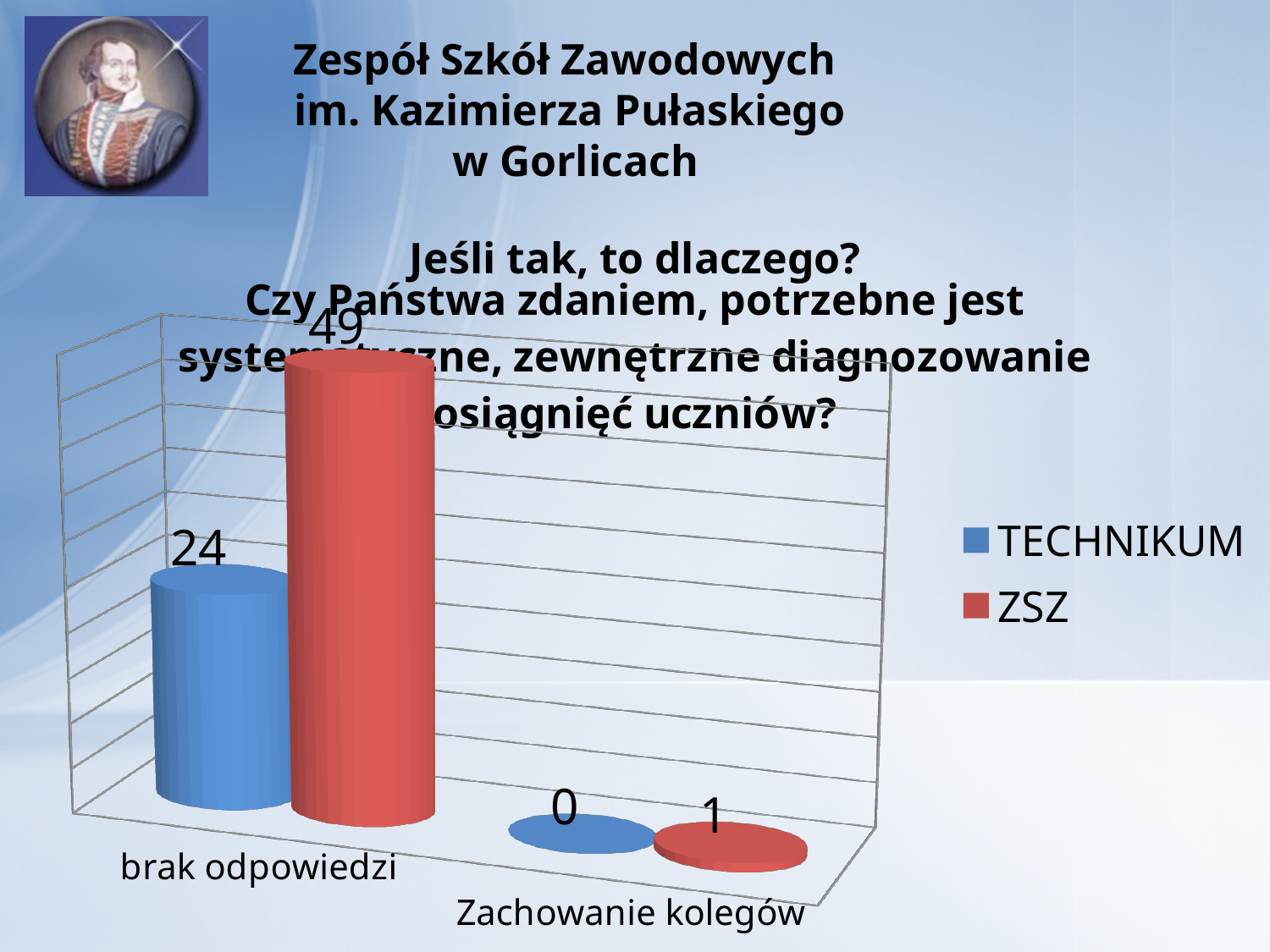
Which series has the highest value in the "brak odpowiedzi" category? ZSZ Which colour represents the ZSZ series in the chart? Red What kind of chart is shown on the slide? Bar chart What is the difference between the ZSZ and TECHNIKUM values in the "brak odpowiedzi" category? 25 How many categories are shown on the chart? 2 What is the value for TECHNIKUM in the "brak odpowiedzi" category? 24 Which is larger: the ZSZ value for "Zachowanie kolegów" or the TECHNIKUM value for "Zachowanie kolegów"? ZSZ How many series does the legend list? 2 What is the value for TECHNIKUM in the "Zachowanie kolegów" category? 0 What is the value for ZSZ in the "brak odpowiedzi" category? 49 Which category has the lowest value for the ZSZ series? Zachowanie kolegów What is the value for ZSZ in the "Zachowanie kolegów" category? 1